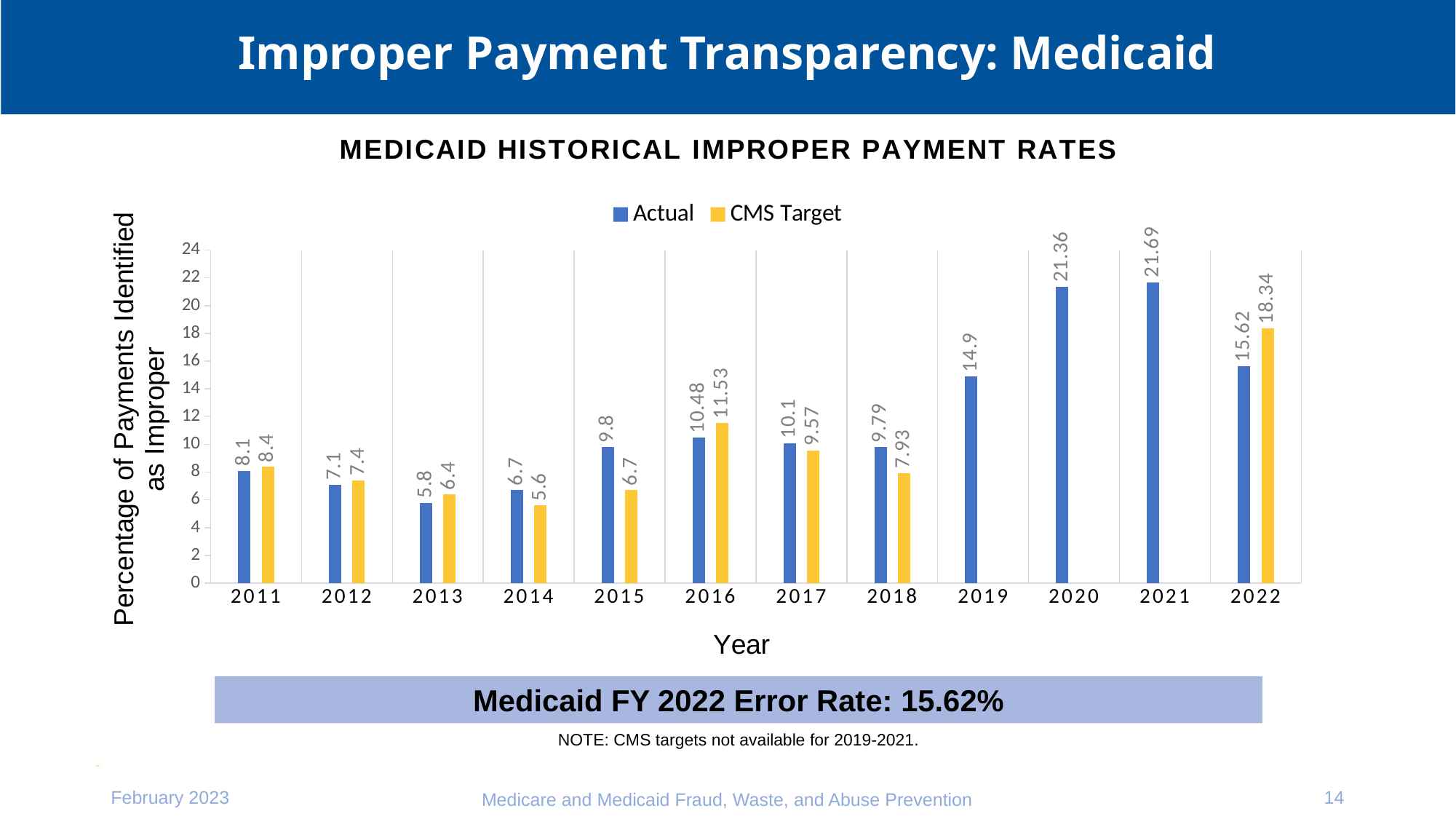
What is the difference between the CMS Target and the Actual value for 2022? 2.72 Which year has the lowest Actual improper payment rate? 2013 Which series is shown in yellow in the legend? CMS Target Which year has the highest Actual improper payment rate? 2021 How many series does the legend list? 2 What is the Actual improper payment rate for 2021? 21.69 Do the Actual values rise or fall from 2018 to 2021? Rise What kind of chart is shown on the slide? Bar chart Which is larger for 2018, the Actual value or the CMS Target? Actual What is the CMS Target value for 2016? 11.53 What is the Actual value for 2013? 5.8 How many years are shown on the x axis? 12